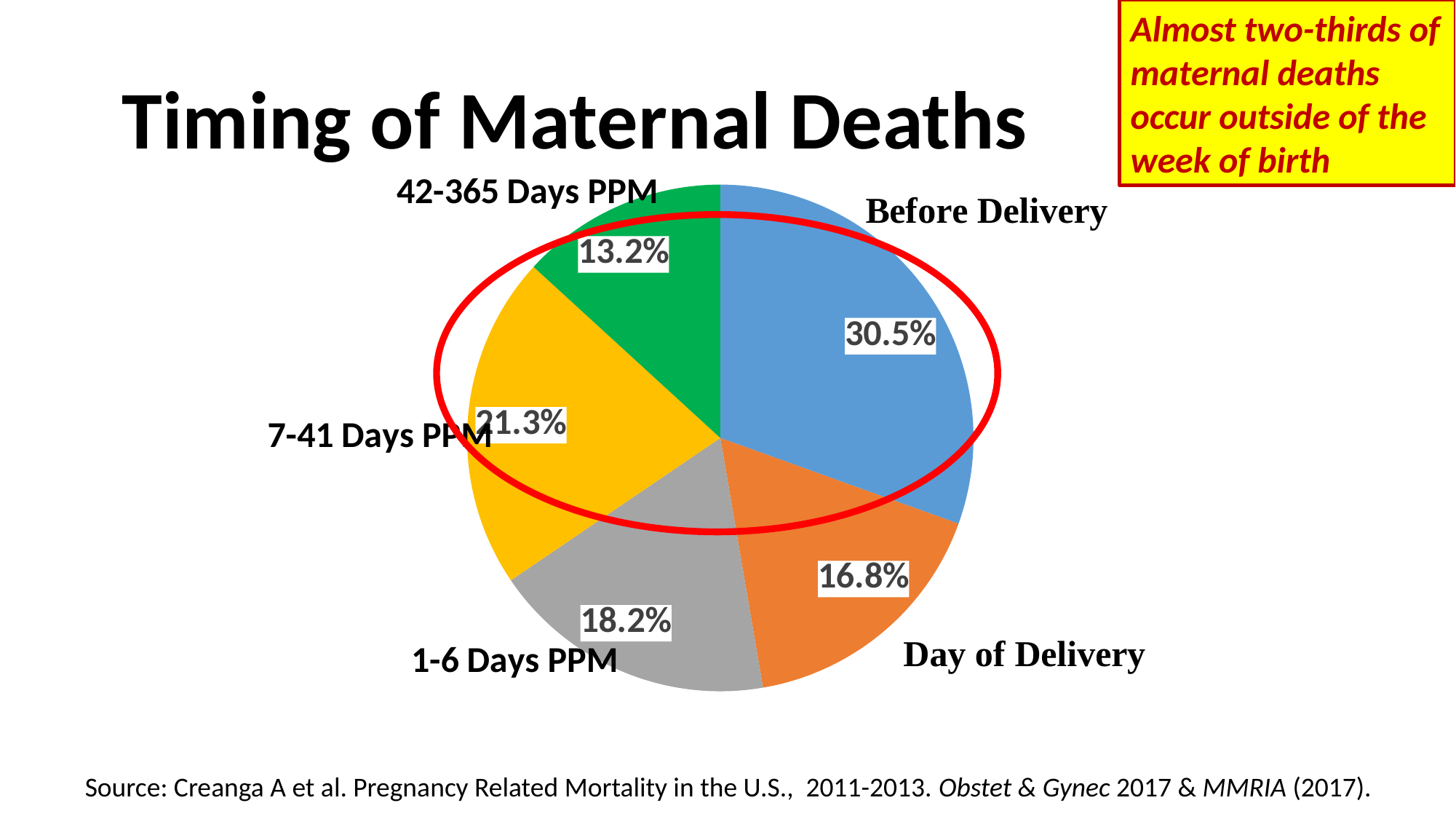
What colour is the slice for Before Delivery? Blue What percentage of maternal deaths occur 1-6 Days PPM? 18.2% What percentage of maternal deaths occur on the Day of Delivery? 16.8% Which timing category has the smallest share of maternal deaths? 42-365 Days PPM What is the difference in percentage points between Before Delivery and Day of Delivery? 13.7 What percentage of maternal deaths occur Before Delivery? 30.5% What percentage of maternal deaths occur 7-41 Days PPM? 21.3% Which is larger: the share for 1-6 Days PPM or the share for 7-41 Days PPM? 7-41 Days PPM Which timing category has the largest share of maternal deaths? Before Delivery What percentage of maternal deaths occur 42-365 Days PPM? 13.2% How many categories are shown in the pie chart? 5 What type of chart is shown on the slide? Pie chart